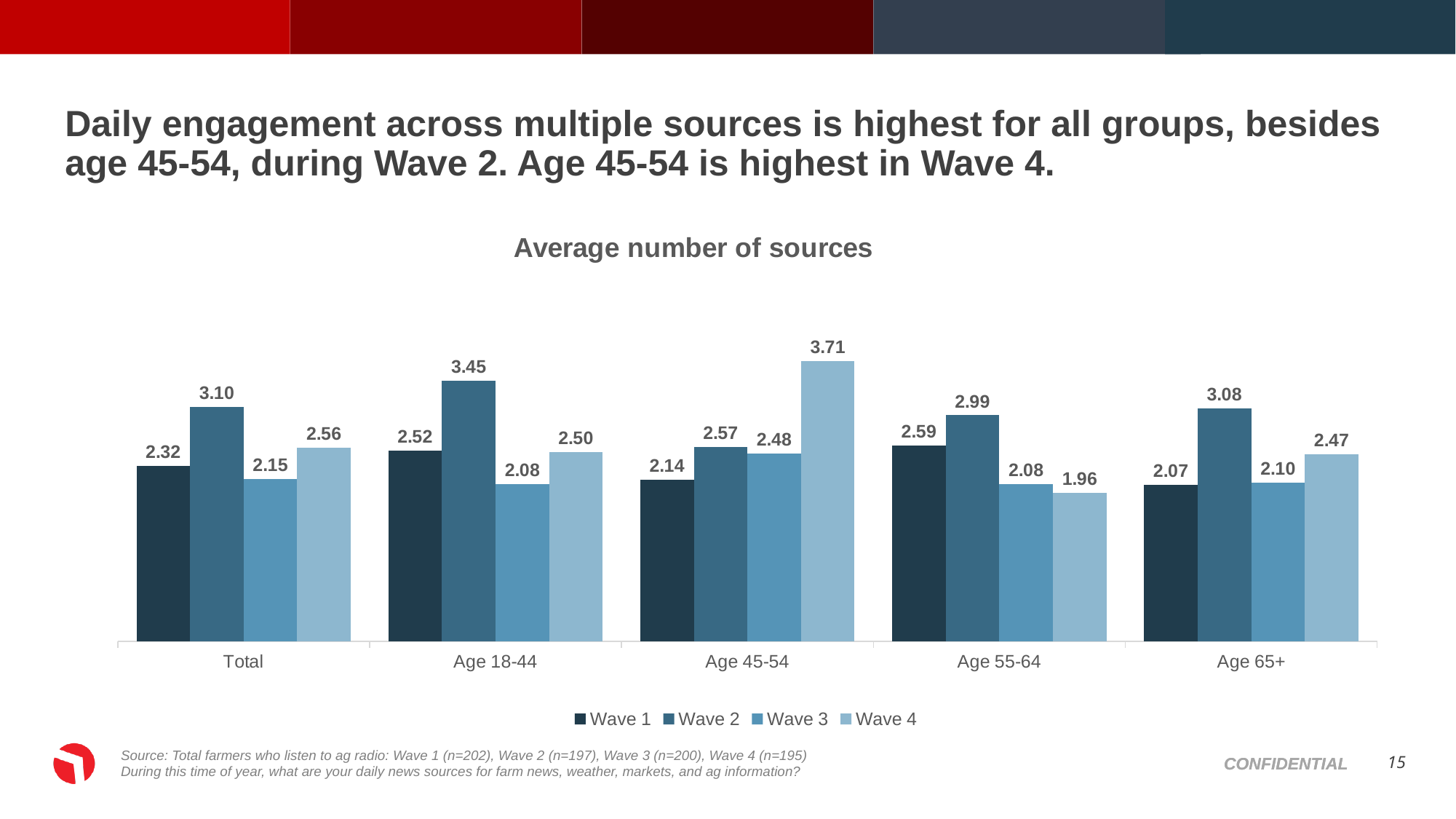
What is the difference between the Wave 2 and Wave 1 values for Age 18-44? 0.93 How many categories are shown on the x axis? 5 What is the Wave 4 value for Age 45-54? 3.71 How many series does the legend list? 4 Which category has the lowest Wave 4 value? Age 55-64 What is the difference between the Wave 4 and Wave 3 values for Age 45-54? 1.23 Which age group has the highest Wave 2 value? Age 18-44 Which is larger for Age 55-64: the Wave 1 value or the Wave 3 value? Wave 1 What kind of chart is shown on the slide? Bar chart What is the Wave 2 value for Total? 3.10 What is the title of the chart? Average number of sources What is the Wave 3 value for Age 65+? 2.10